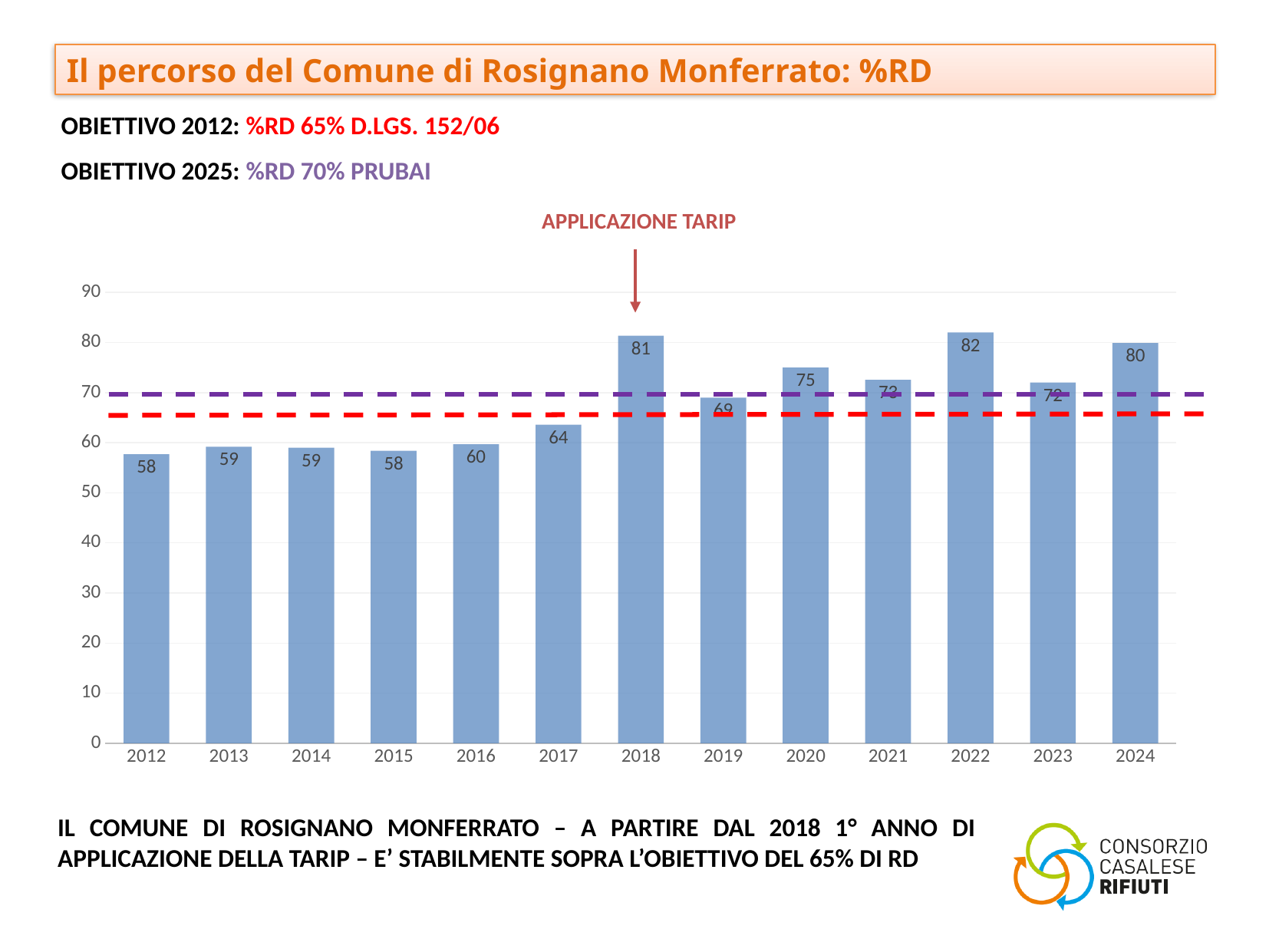
Which year has the highest %RD value? 2022 What is the %RD value for 2017? 64 Is the value for 2019 greater or less than 60? greater What is the difference between the %RD values for 2022 and 2012? 24 Which year has the larger %RD value, 2020 or 2024? 2024 What kind of chart is shown on the slide? bar chart What is the difference between the %RD values for 2018 and 2017? 17 Which year does the 'APPLICAZIONE TARIP' arrow point to? 2018 How many years are shown on the x axis of the chart? 13 What is the %RD value for 2024? 80 What is the %RD value for 2018? 81 What is the %RD value for 2012? 58